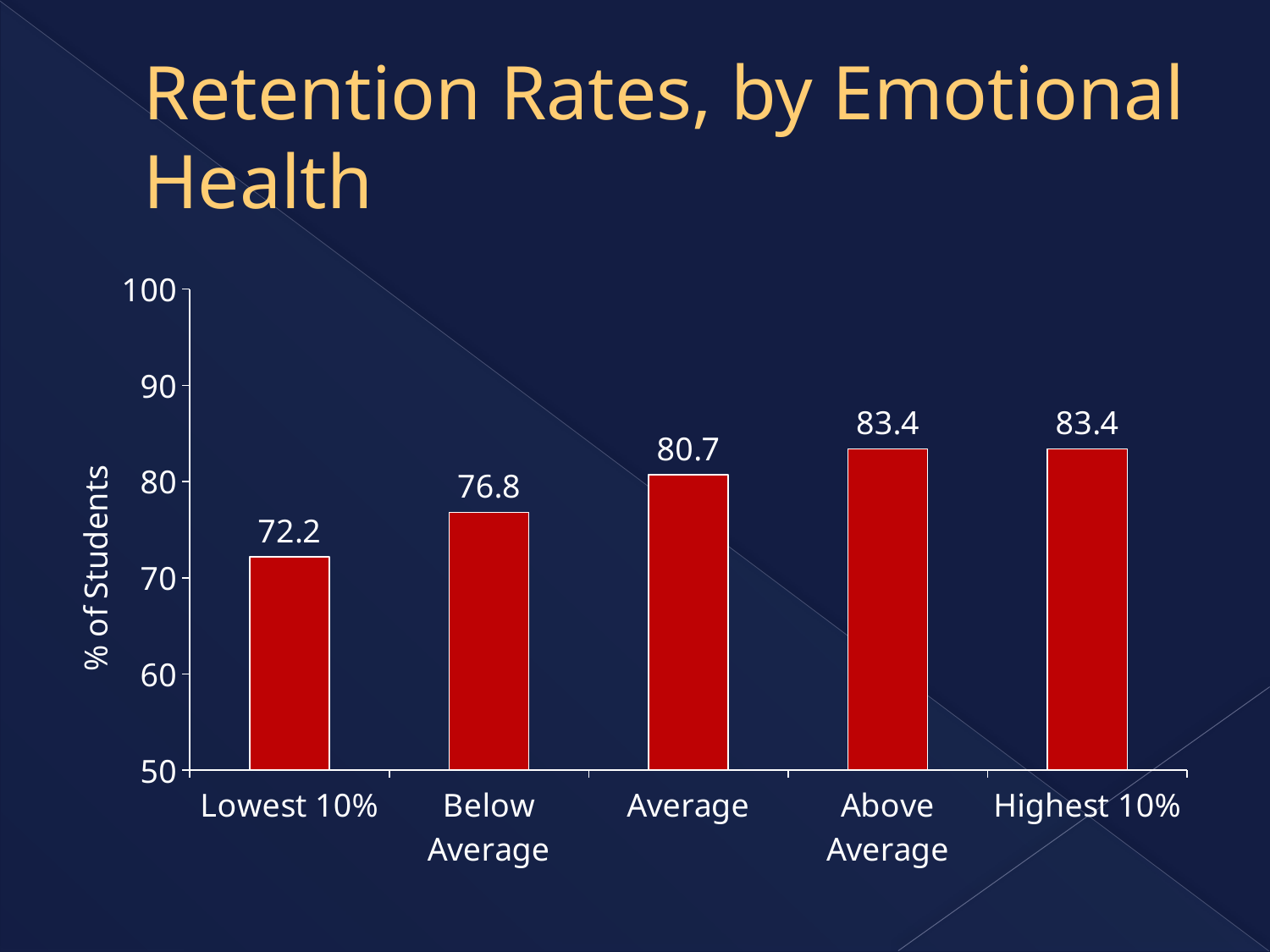
What is the difference between the values for Highest 10% and Lowest 10%? 11.2 What is the label of the y axis? % of Students What is the retention rate for the Lowest 10% emotional health group? 72.2 Which category has the lowest retention rate? Lowest 10% What is the value for the Highest 10% category? 83.4 What is the value shown for the Average category? 80.7 What is the value for the Below Average category? 76.8 Which is larger, the value for Above Average or the value for Average? Above Average What kind of chart is shown on the slide? bar chart How many categories are shown on the x axis? 5 Is the value for Below Average greater or less than 80? less What is the difference between the Average and Below Average values? 3.9